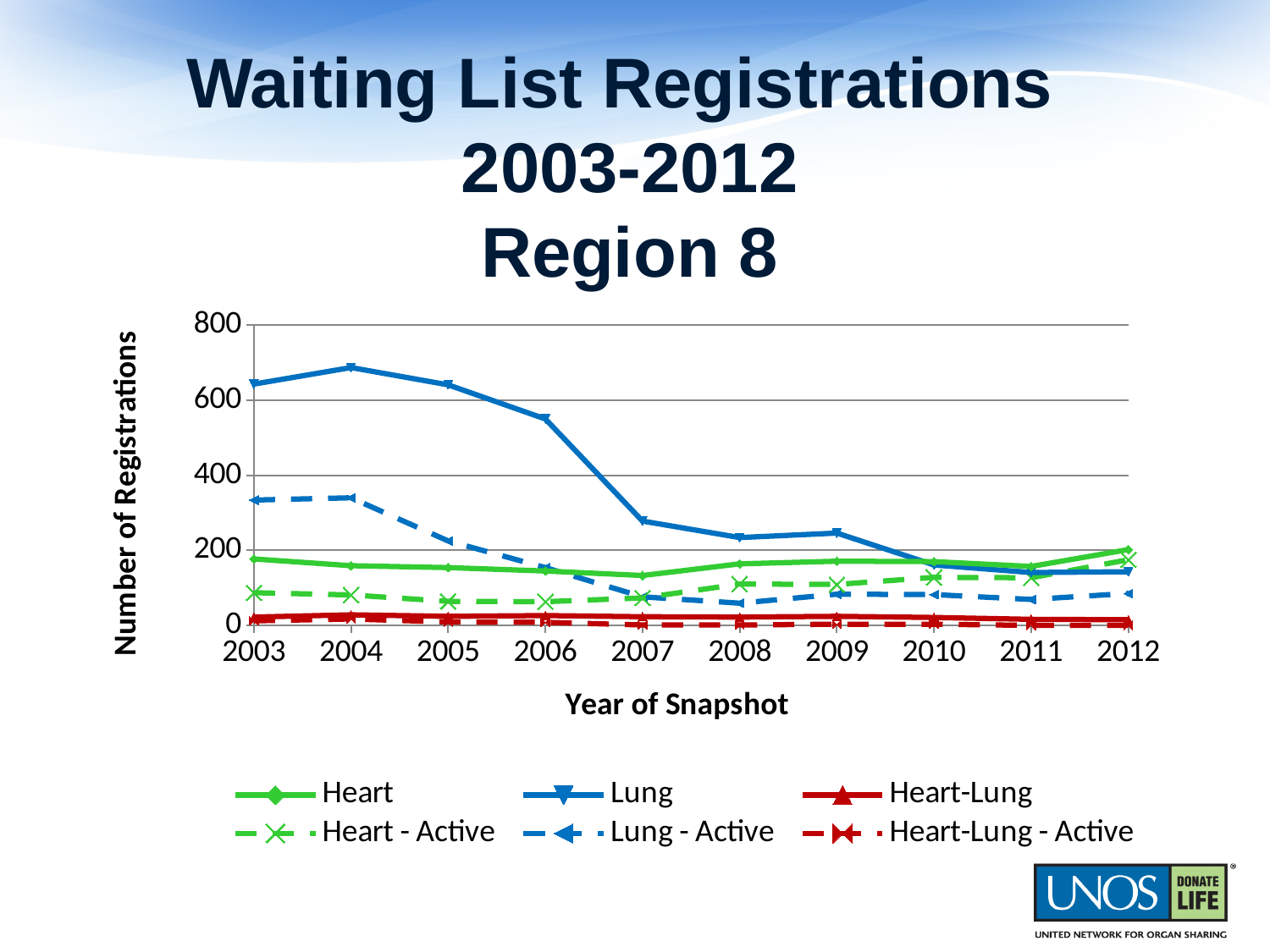
Is the value for Lung in 2004 greater or less than 600? greater In which year is the Lung series at its highest? 2004 Is the value for Heart-Lung in 2012 greater or less than 200? less How many years are shown along the x axis? 10 In 2003, which is larger: Lung or Heart? Lung Is the value for Lung in 2007 greater or less than 400? less How many series does the legend list? 6 What kind of chart is shown on the slide? line chart Does the Lung series rise or fall from 2003 to 2012? fall What is the title of the x axis? Year of Snapshot What is the title of the y axis? Number of Registrations